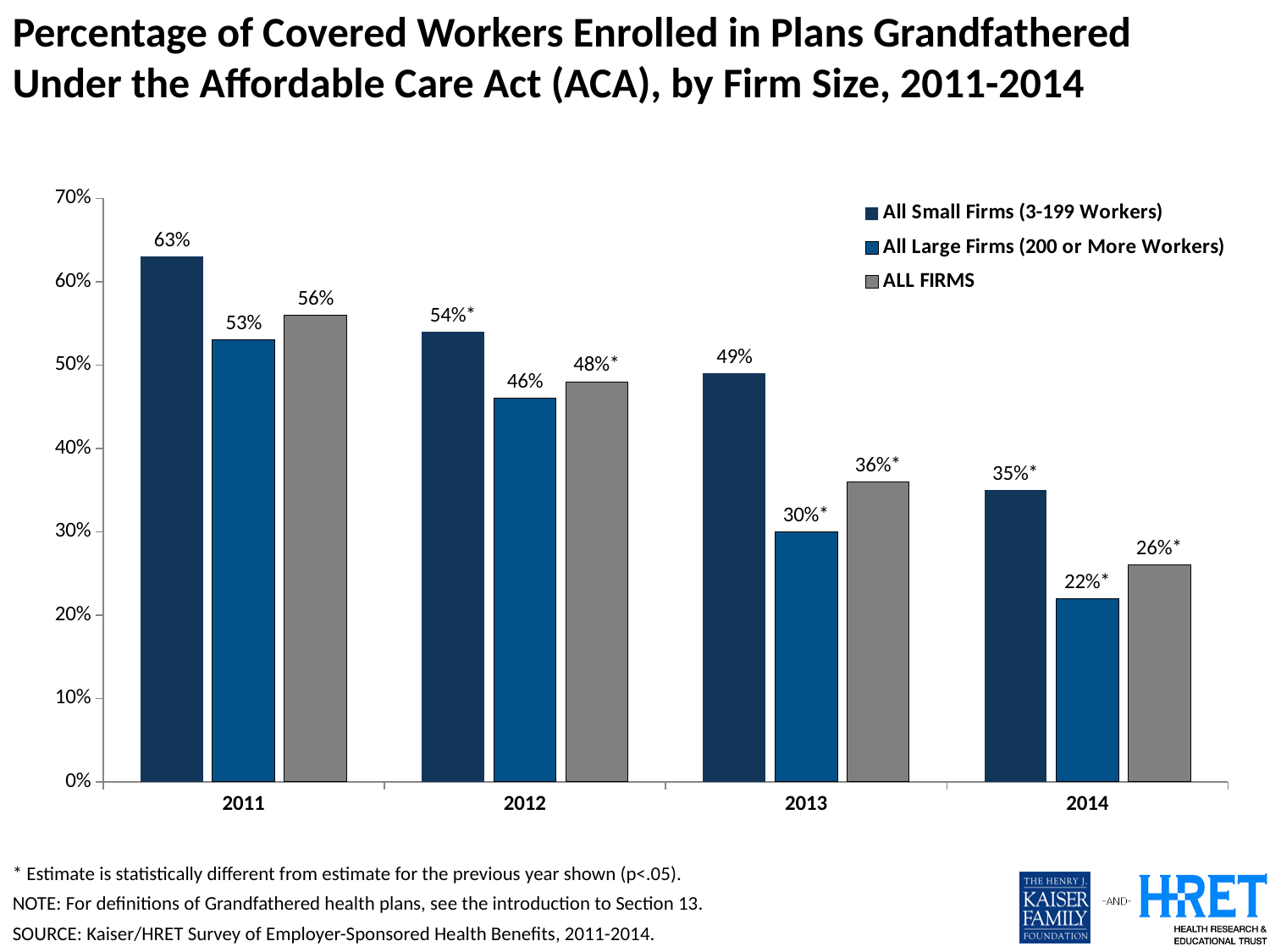
What percentage of covered workers at All Small Firms (3-199 Workers) were enrolled in grandfathered plans in 2011? 63% In which year is the value for ALL FIRMS the lowest? 2014 What is the difference between the All Small Firms and All Large Firms values in 2013? 19 percentage points In which year is the value for All Small Firms (3-199 Workers) the highest? 2011 What kind of chart is shown on the slide? Bar chart Does the value for ALL FIRMS rise or fall from 2011 to 2014? Fall Which is larger in 2012: the value for All Large Firms (200 or More Workers) or the value for ALL FIRMS? ALL FIRMS How many years are shown on the x axis? 4 Is the value for All Small Firms (3-199 Workers) in 2014 greater or less than 30%? greater What is the value for ALL FIRMS in 2013? 36%* What is the value for All Large Firms (200 or More Workers) in 2014? 22%* How many series does the legend list? 3